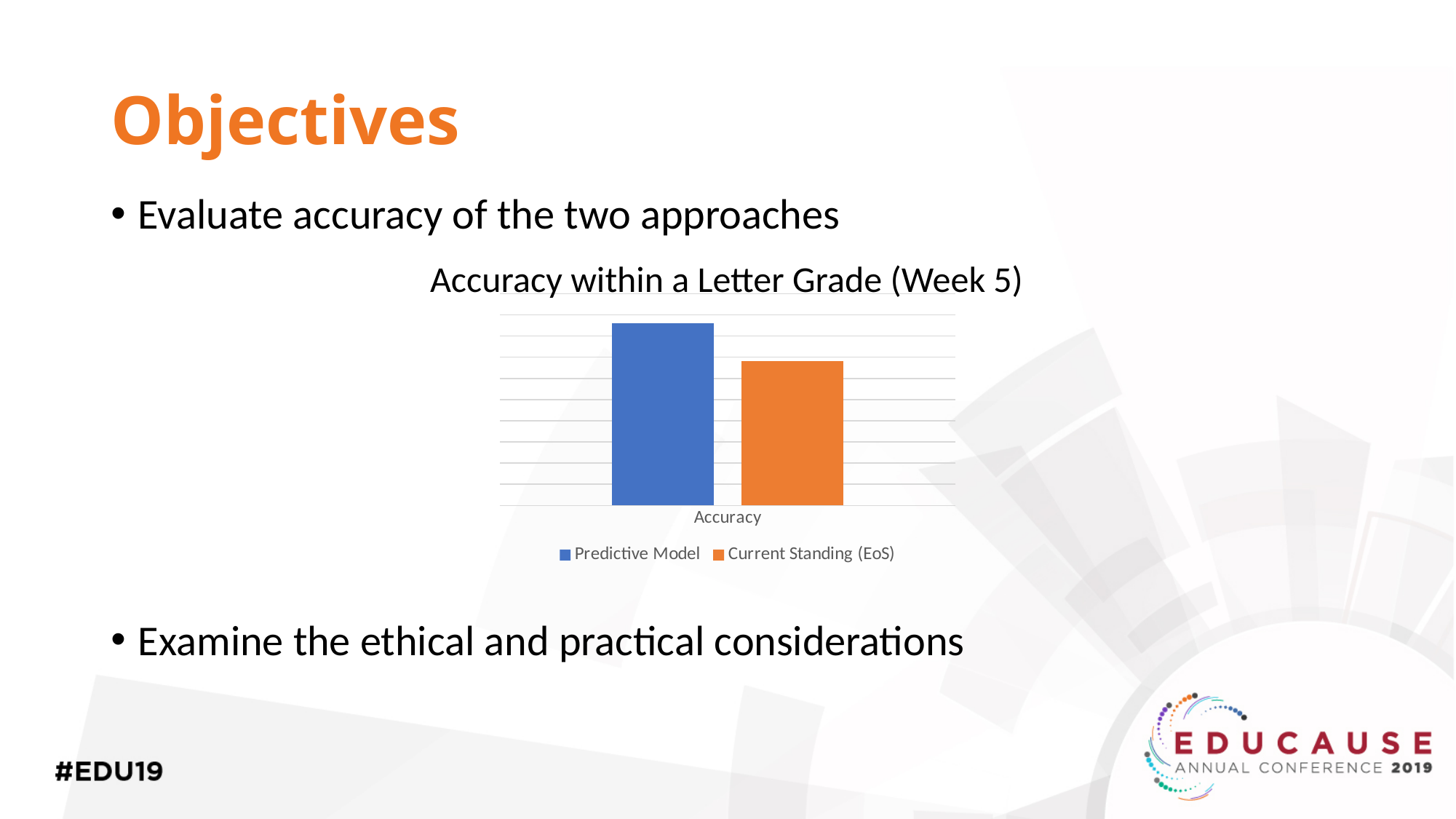
Which series has the tallest bar in the chart? Predictive Model What is the name of the category on the x axis? Accuracy Which series has the shortest bar in the chart? Current Standing (EoS) What is the title of the chart? Accuracy within a Letter Grade (Week 5) Is the bar for Current Standing (EoS) taller or shorter than the bar for Predictive Model? shorter How many categories are shown on the x axis of the chart? 1 What kind of chart is shown on the slide? bar chart Which series has the higher bar in the chart, Predictive Model or Current Standing (EoS)? Predictive Model How many series does the chart's legend list? 2